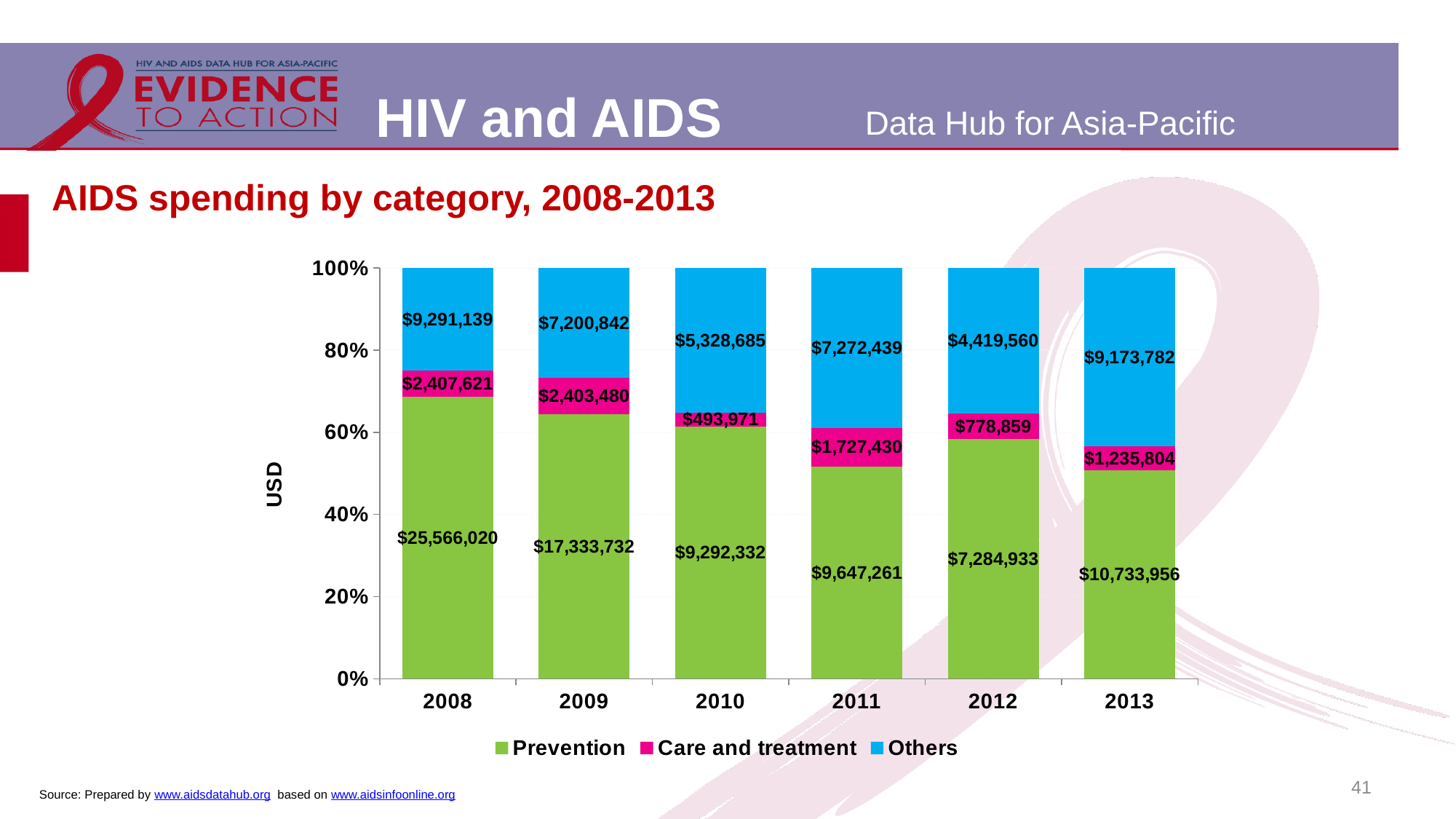
What was the Prevention spending in 2008? $25,566,020 Which was larger in 2011: Prevention spending or Others spending? Prevention What was the Care and treatment spending in 2010? $493,971 Which year had the lowest Care and treatment spending? 2010 Which year had the highest Prevention spending? 2008 How many series does the legend list? 3 How many years are shown on the x axis? 6 What kind of chart is shown on the slide? Stacked bar chart Is the Prevention share of spending in 2013 greater or less than 40%? greater What was the Others spending in 2013? $9,173,782 What is the total AIDS spending across all three categories in 2012? $12,483,352 What is the difference between Prevention spending in 2008 and 2009? $8,232,288